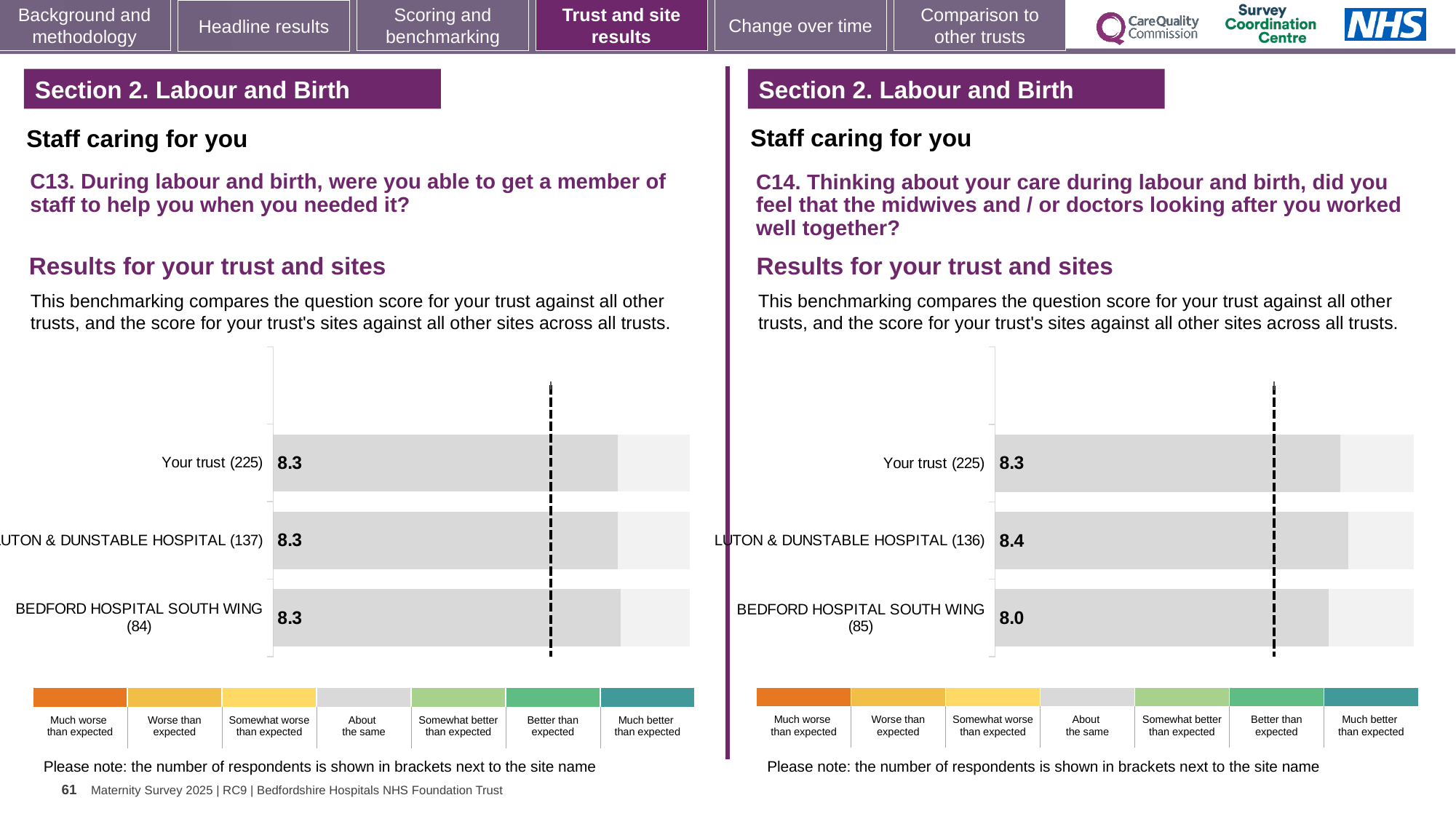
How many categories does the colour legend below the C13 chart on the left list? 7 In the C14 chart on the right, which site or trust has the highest score? Luton & Dunstable Hospital In the C14 chart on the right, which site or trust has the lowest score? Bedford Hospital South Wing In the C14 chart on the right, which has the larger score: Your trust or Bedford Hospital South Wing? Your trust What type of chart is used for the C13 results on the left? Bar chart In the C13 chart on the left, what is the score for Your trust? 8.3 In the C14 chart on the right, what is the score for Luton & Dunstable Hospital? 8.4 In the C14 chart on the right, what is the difference between the scores for Luton & Dunstable Hospital and Bedford Hospital South Wing? 0.4 In the C14 chart on the right, how many respondents are shown in brackets for Bedford Hospital South Wing? 85 How many bars are plotted in the C13 chart on the left? 3 In the C13 chart on the left, what is the score for Bedford Hospital South Wing? 8.3 In the C14 chart on the right, what is the score for Bedford Hospital South Wing? 8.0